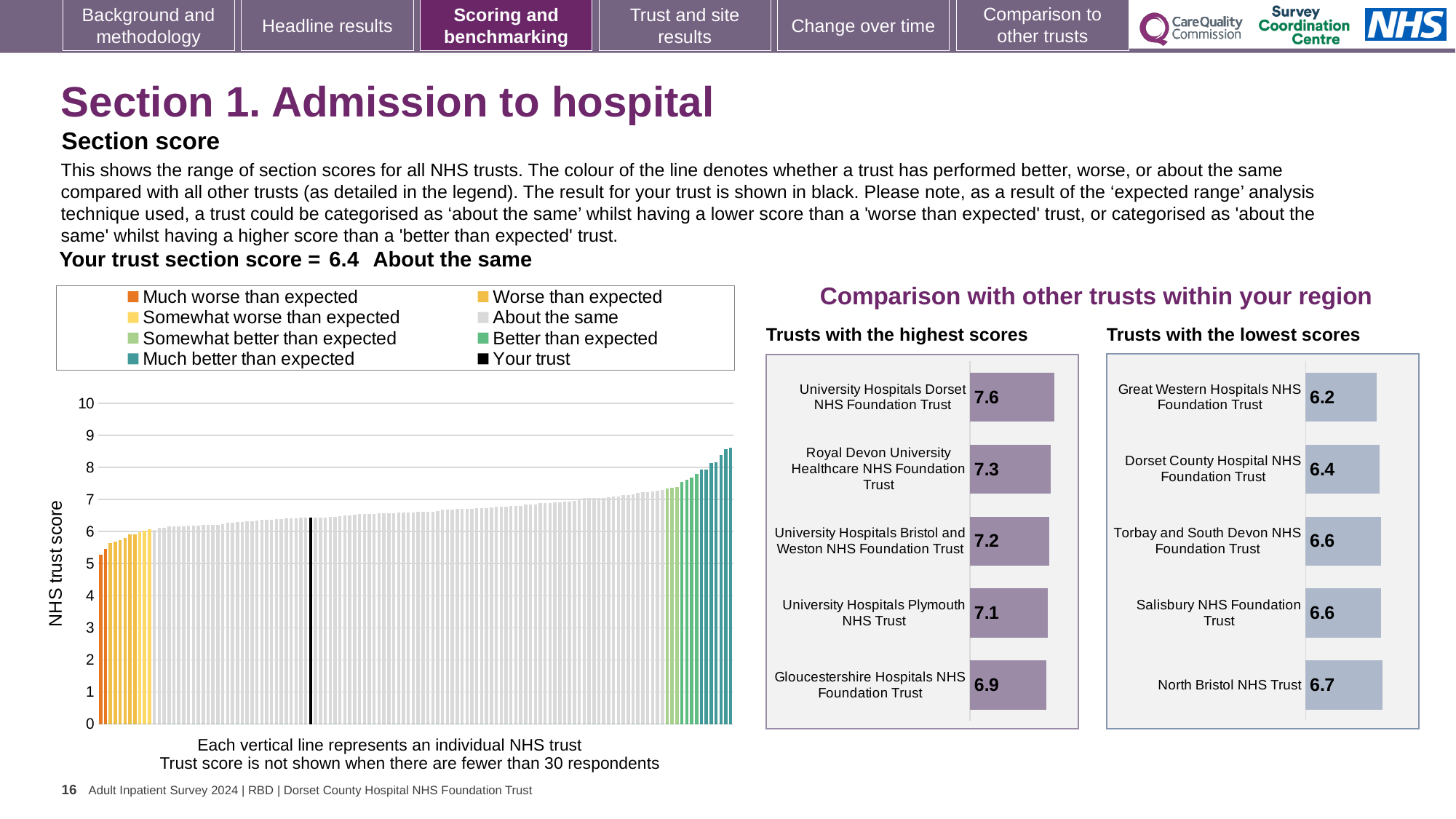
In the 'Trusts with the lowest scores' chart, what is the difference between the scores of North Bristol NHS Trust and Great Western Hospitals NHS Foundation Trust? 0.5 In the 'Trusts with the highest scores' chart, what is the score for University Hospitals Dorset NHS Foundation Trust? 7.6 In the 'Trusts with the lowest scores' chart, which trust has the highest score shown? North Bristol NHS Trust In the 'Trusts with the lowest scores' chart, which has the larger score: Dorset County Hospital NHS Foundation Trust or North Bristol NHS Trust? North Bristol NHS Trust In the large 'NHS trust score' chart on the left, do the values rise or fall from left to right? Rise In the 'Trusts with the highest scores' chart, which trust has the lowest score shown? Gloucestershire Hospitals NHS Foundation Trust In the 'Trusts with the lowest scores' chart, what is the score for Salisbury NHS Foundation Trust? 6.6 In the 'Trusts with the highest scores' chart, what is the difference between the scores of University Hospitals Dorset NHS Foundation Trust and Gloucestershire Hospitals NHS Foundation Trust? 0.7 What kind of chart is the large 'NHS trust score' chart on the left of the slide? Bar chart How many entries does the legend of the large 'NHS trust score' chart on the left list? 8 In the 'Trusts with the lowest scores' chart, what is the score for Great Western Hospitals NHS Foundation Trust? 6.2 In the 'Trusts with the highest scores' chart, how many trusts are shown? 5